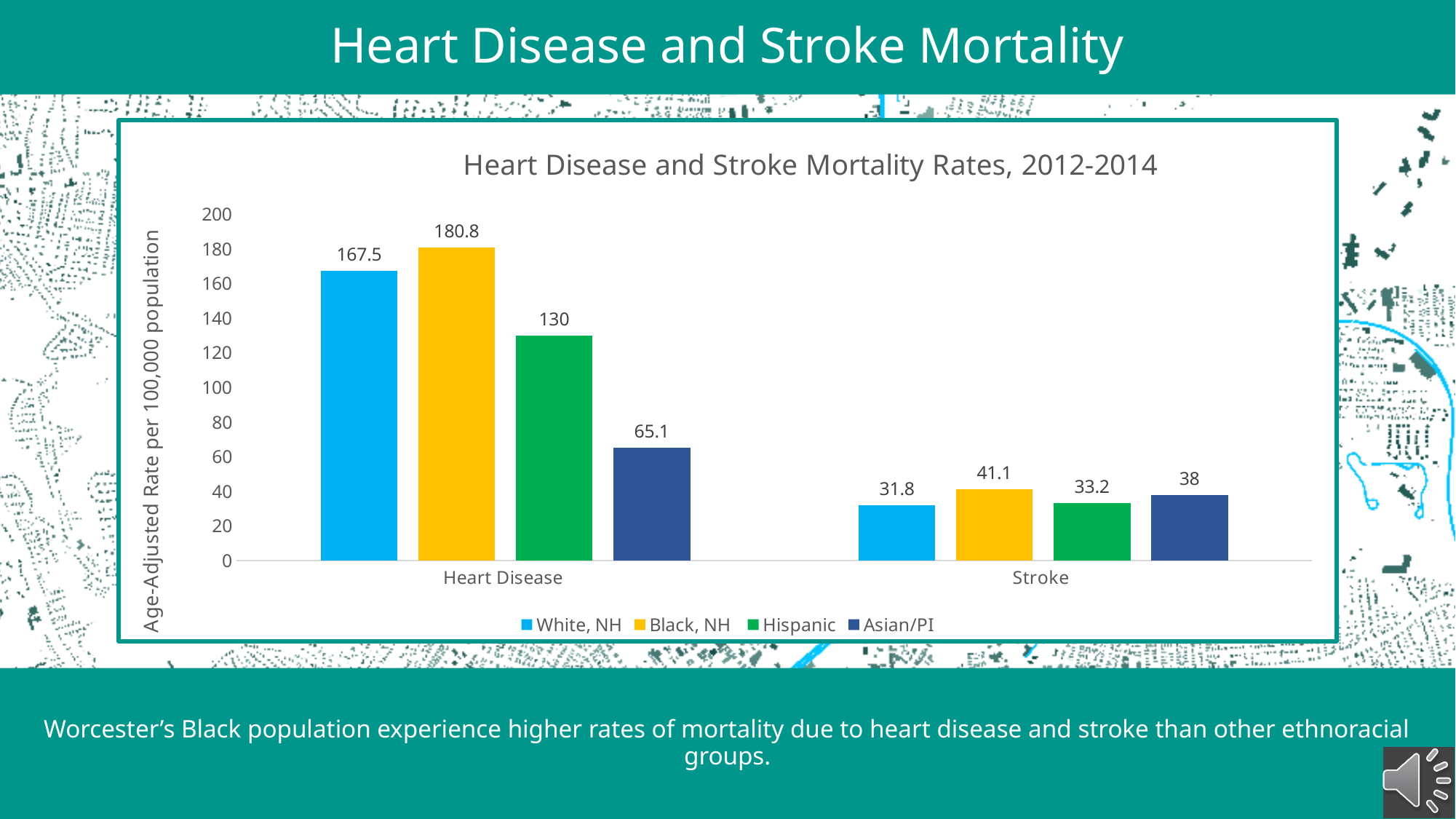
How many series does the legend list? 4 What is the label of the y axis? Age-Adjusted Rate per 100,000 population What is the stroke mortality rate for Hispanic? 33.2 Which group has the highest heart disease mortality rate? Black, NH What is the heart disease mortality rate for Asian/PI? 65.1 How many categories are shown on the x axis? 2 What is the title of the chart? Heart Disease and Stroke Mortality Rates, 2012-2014 Which is larger: the stroke mortality rate for Asian/PI or for Hispanic? Asian/PI Which group has the lowest stroke mortality rate? White, NH What kind of chart is shown? Bar chart What is the heart disease mortality rate for Black, NH? 180.8 What is the difference between the heart disease mortality rates for Black, NH and White, NH? 13.3